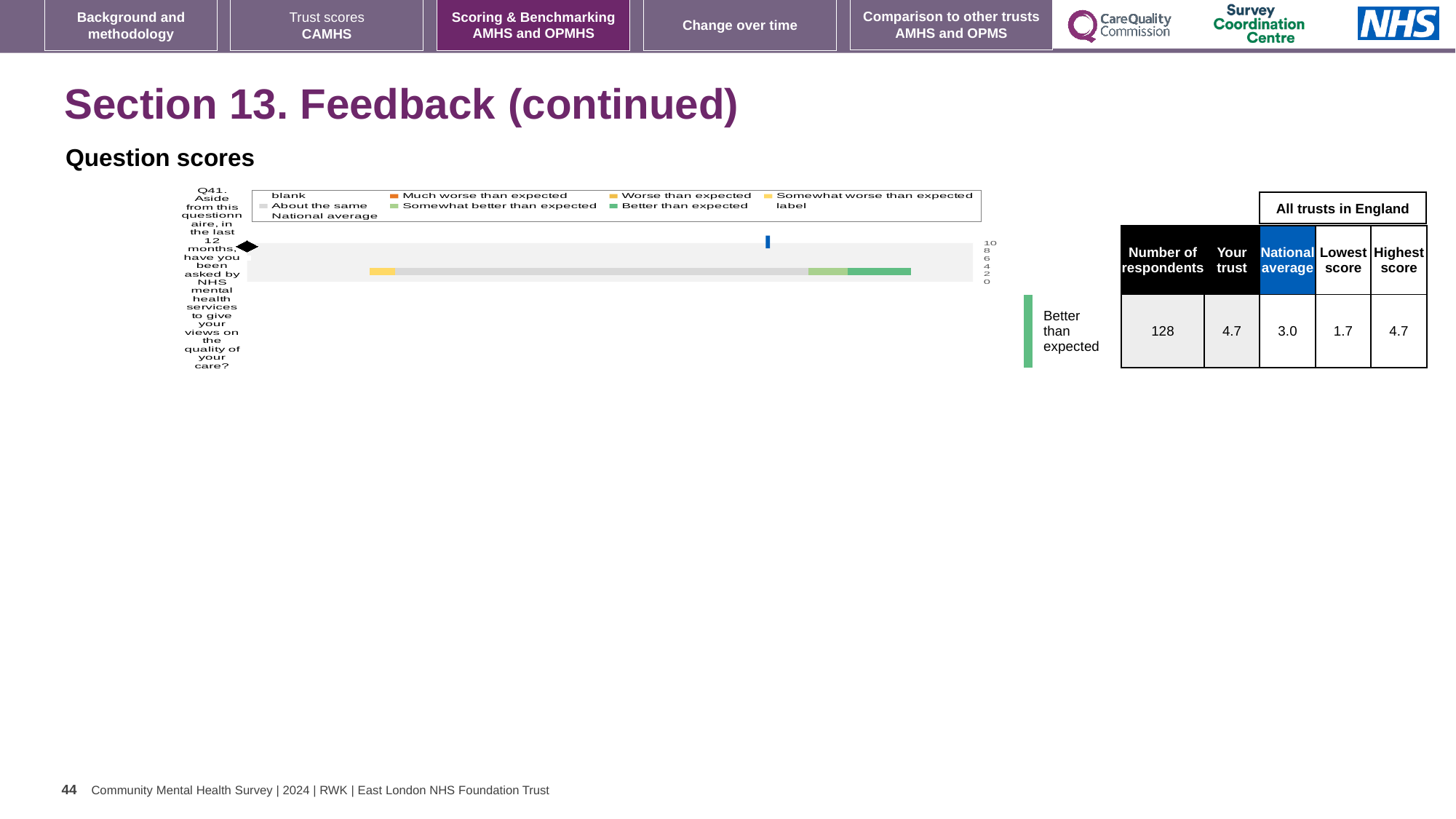
Which is larger for Q41: the 'Your trust' score or the national average? Your trust In the table beside the chart, what is the lowest score among all trusts in England for Q41? 1.7 What is the difference between the highest score and the lowest score for Q41 in the table? 3.0 What is the difference between the 'Your trust' score and the national average for Q41? 1.7 In the table beside the chart, what is the national average score for Q41? 3.0 In the table beside the chart, what is the highest score among all trusts in England for Q41? 4.7 What kind of chart is shown on the slide? bar chart Which benchmark category is the trust's result for Q41 labelled as, to the right of the chart? Better than expected In the table beside the chart, what is the 'Your trust' score for Q41? 4.7 In the table beside the chart, what is the number of respondents for Q41? 128 How many survey questions are plotted in the chart? 1 Which question number is plotted in the chart? Q41